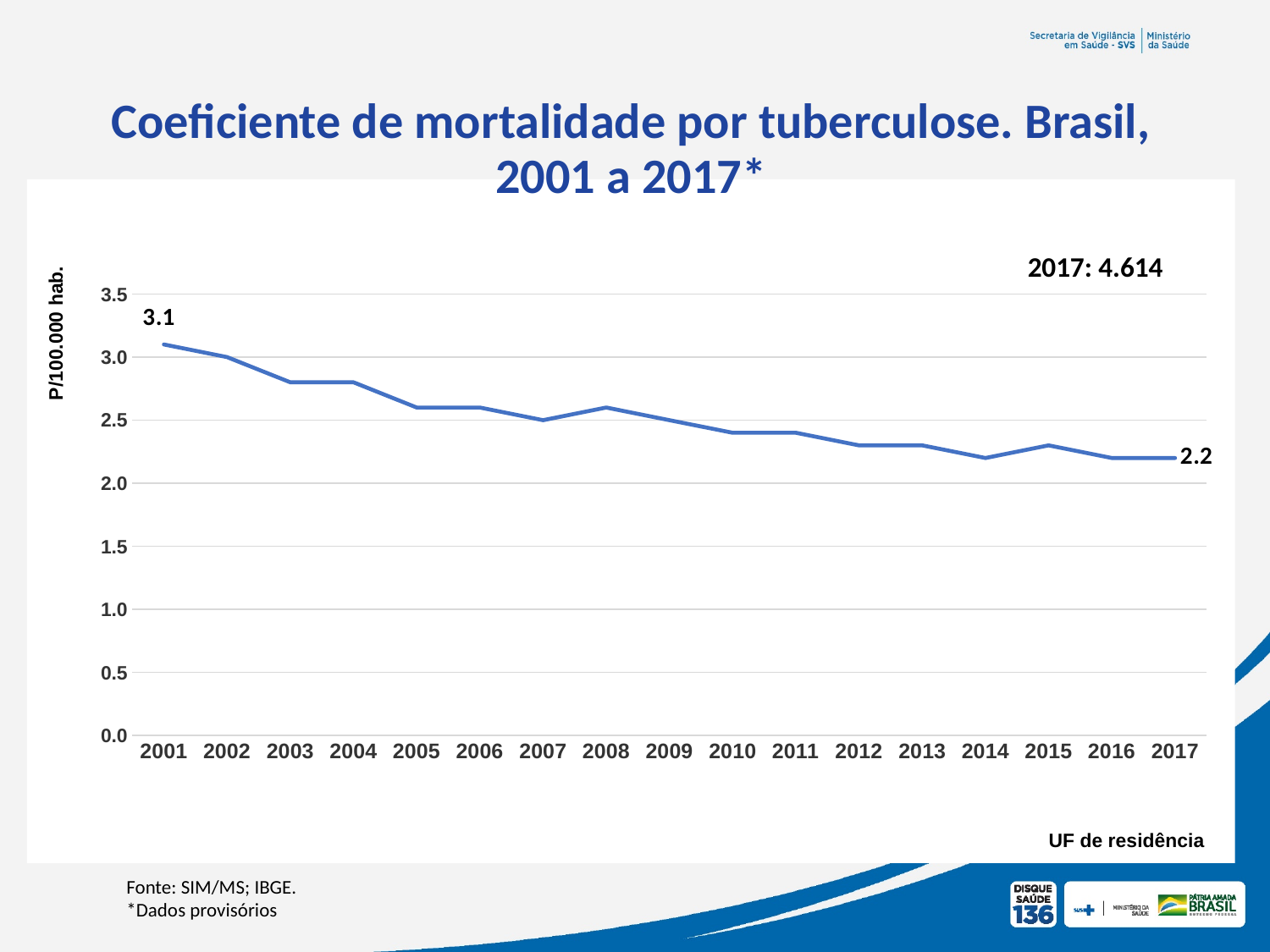
Is the value for 2003 greater or less than 3.0? less How many years are plotted on the x axis? 17 What is the label on the y axis? P/100.000 hab. Which year has the highest value? 2001 What is the value for 2001? 3.1 Which is larger, the value for 2001 or the value for 2017? 2001 What kind of chart is shown? line chart Is the value for 2010 greater or less than 2.5? less Is the value for 2005 greater or less than 2.5? greater What is the value for 2017? 2.2 Do the values generally rise or fall from 2001 to 2017? fall What is the difference between the values for 2001 and 2017? 0.9